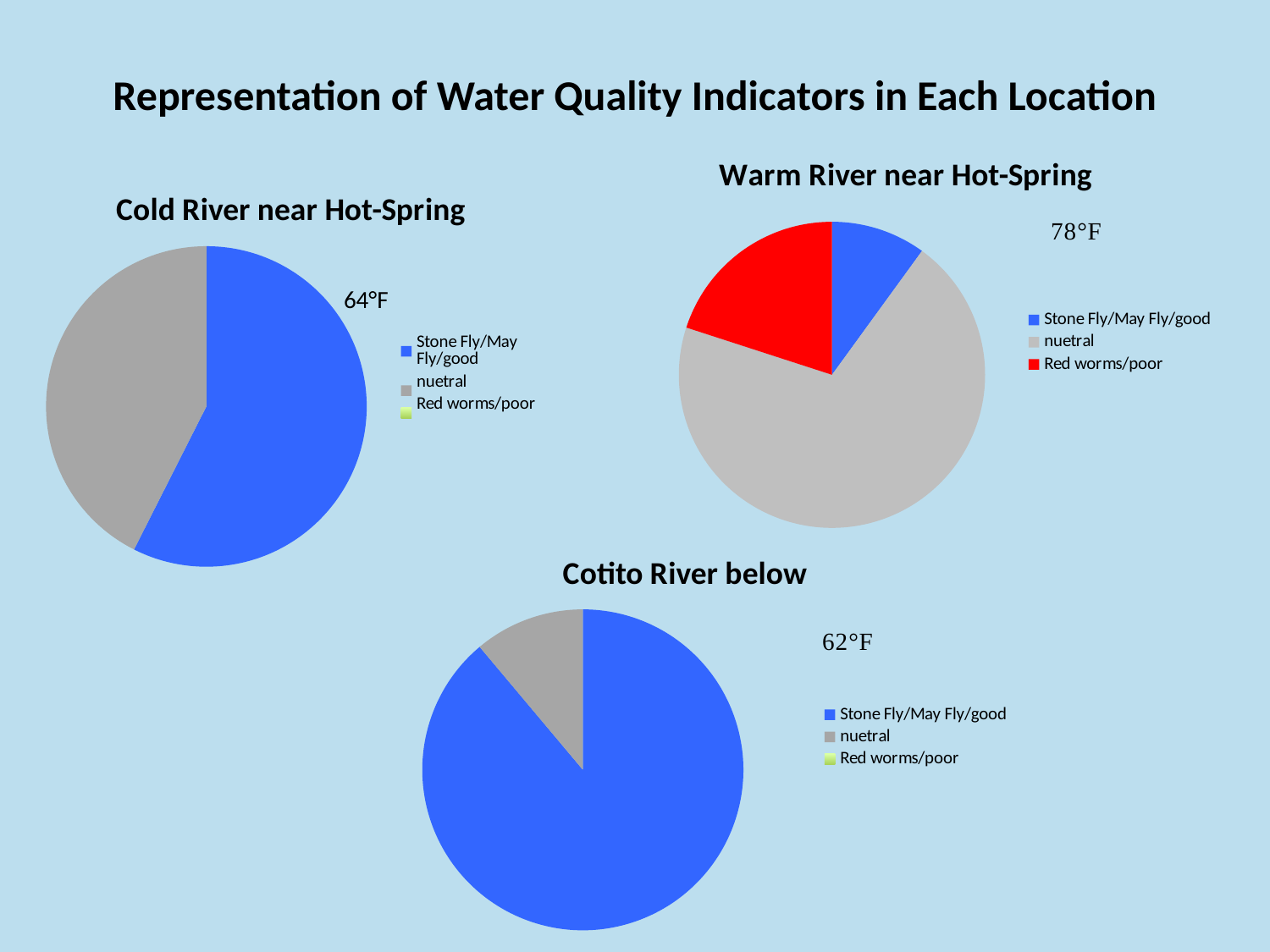
In the "Cotito River below" chart, which slice is smaller: Stone Fly/May Fly/good or nuetral? nuetral What colour represents Red worms/poor in the "Warm River near Hot-Spring" chart? red How many entries does the legend of the "Warm River near Hot-Spring" chart list? 3 What temperature is shown next to the "Warm River near Hot-Spring" chart? 78°F How many slices are visible in the "Cotito River below" pie chart? 2 What kind of chart is the "Cold River near Hot-Spring" chart? pie chart In the "Cold River near Hot-Spring" chart, which category has the largest slice? Stone Fly/May Fly/good In the "Cold River near Hot-Spring" chart, which slice is larger: Stone Fly/May Fly/good or nuetral? Stone Fly/May Fly/good In the "Cotito River below" chart, which category has the largest slice? Stone Fly/May Fly/good In the "Warm River near Hot-Spring" chart, which slice is larger: Red worms/poor or Stone Fly/May Fly/good? Red worms/poor In the "Warm River near Hot-Spring" chart, which category has the smallest slice? Stone Fly/May Fly/good In the "Warm River near Hot-Spring" chart, which category has the largest slice? nuetral